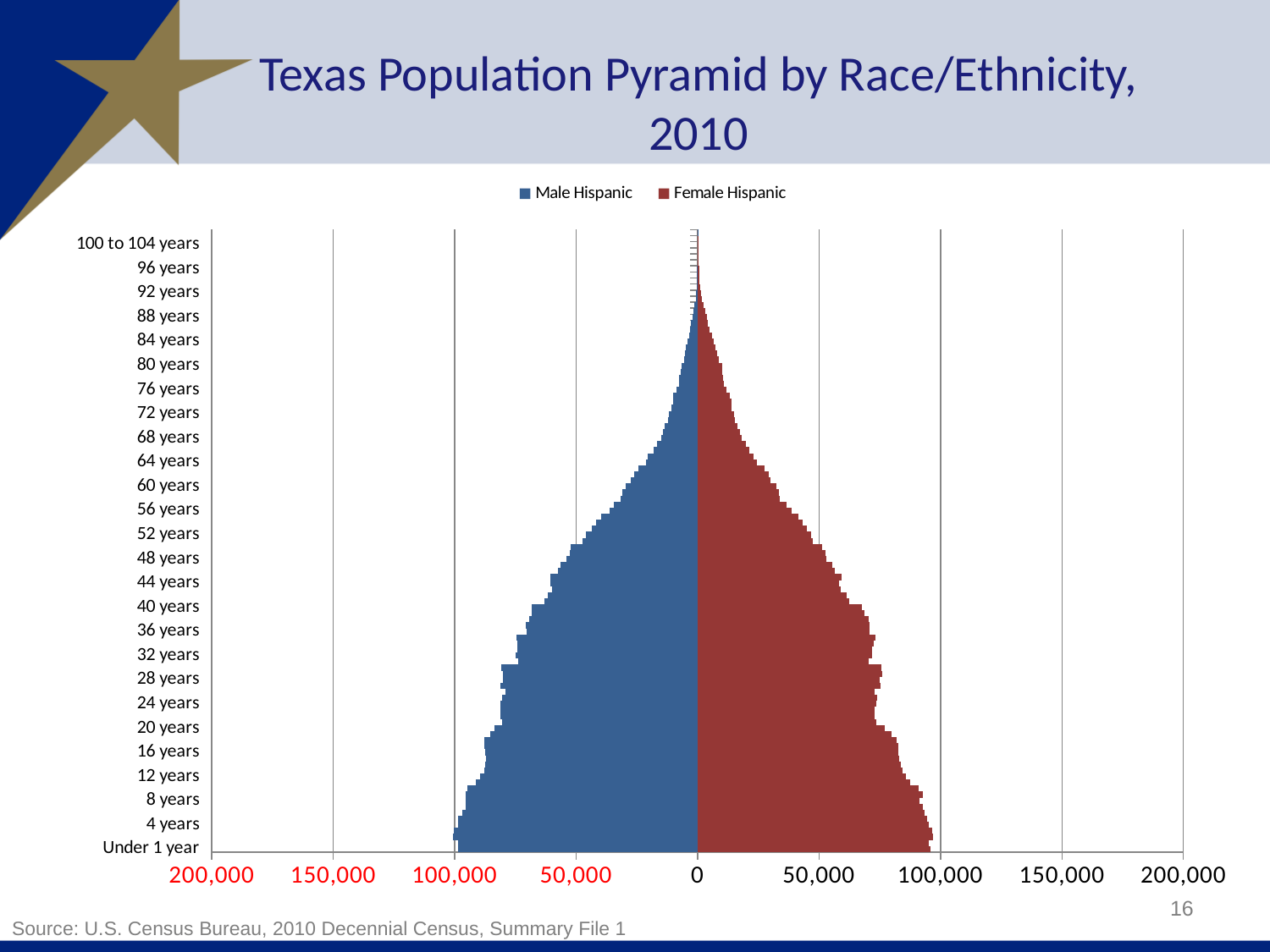
Is the value for Female Hispanic at Under 1 year greater or less than 100,000? less Is the value for Female Hispanic at 20 years greater or less than 50,000? greater Is the value for Male Hispanic at 40 years greater or less than 50,000? greater How many series does the legend list? 2 Which colour represents the Female Hispanic series? Red What kind of chart is shown on the slide? Bar chart Which is larger for Female Hispanic: the value at 4 years or the value at 76 years? 4 years Do the Male Hispanic values generally rise or fall as age increases from Under 1 year to 100 to 104 years? Fall What are the two series named in the legend? Male Hispanic and Female Hispanic